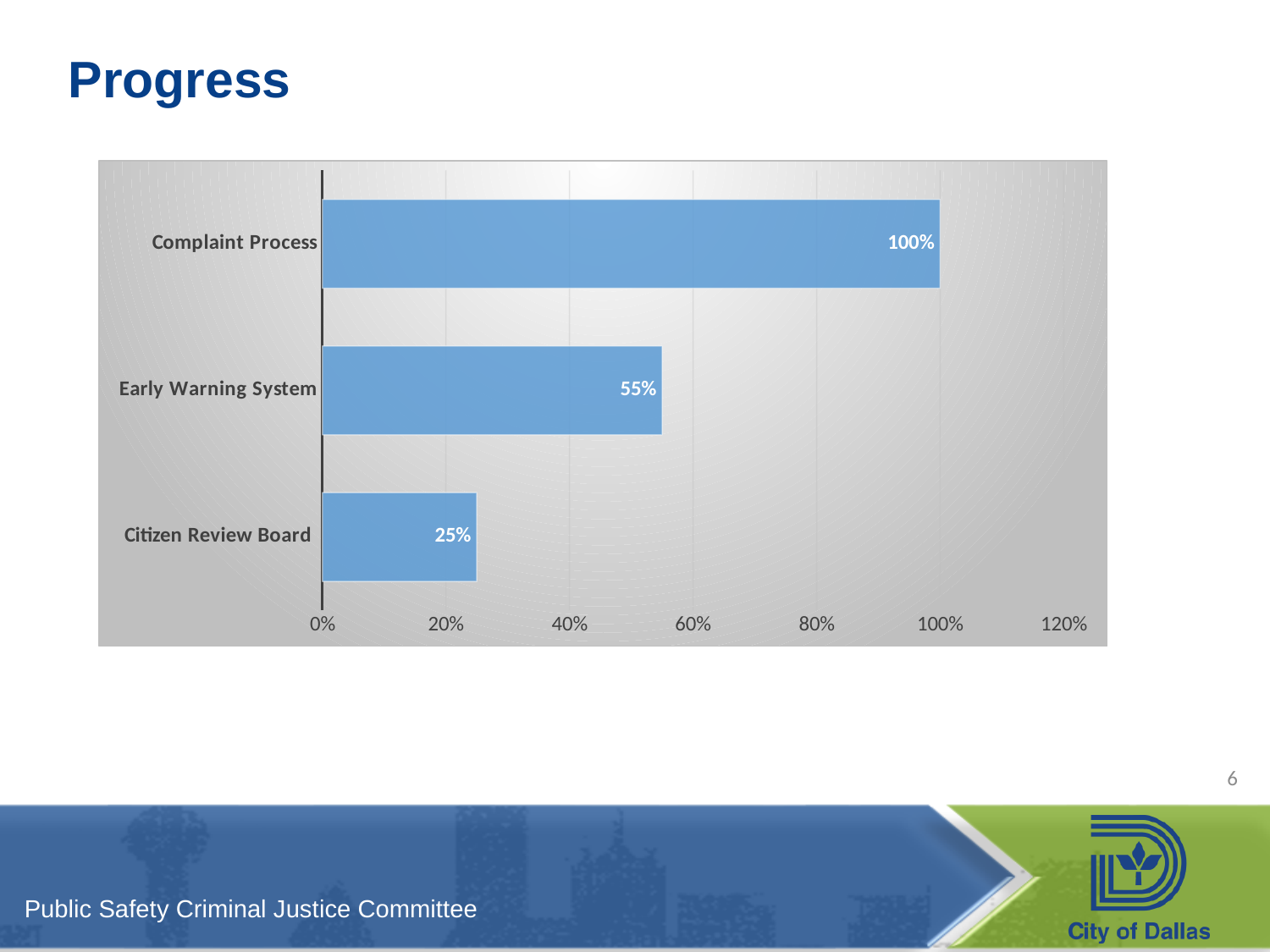
What is the difference between the values for Complaint Process and Early Warning System? 45% What kind of chart is shown on the slide? bar chart Which is larger, the value for Early Warning System or the value for Citizen Review Board? Early Warning System How many categories are shown in the chart? 3 What is the highest value shown on the x axis? 120% Which category has the highest value? Complaint Process What is the difference between the values for Early Warning System and Citizen Review Board? 30% What is the value for Early Warning System? 55% What is the value for Complaint Process? 100% What is the value for Citizen Review Board? 25% Which category has the lowest value? Citizen Review Board Is the value for Early Warning System greater or less than 40%? greater